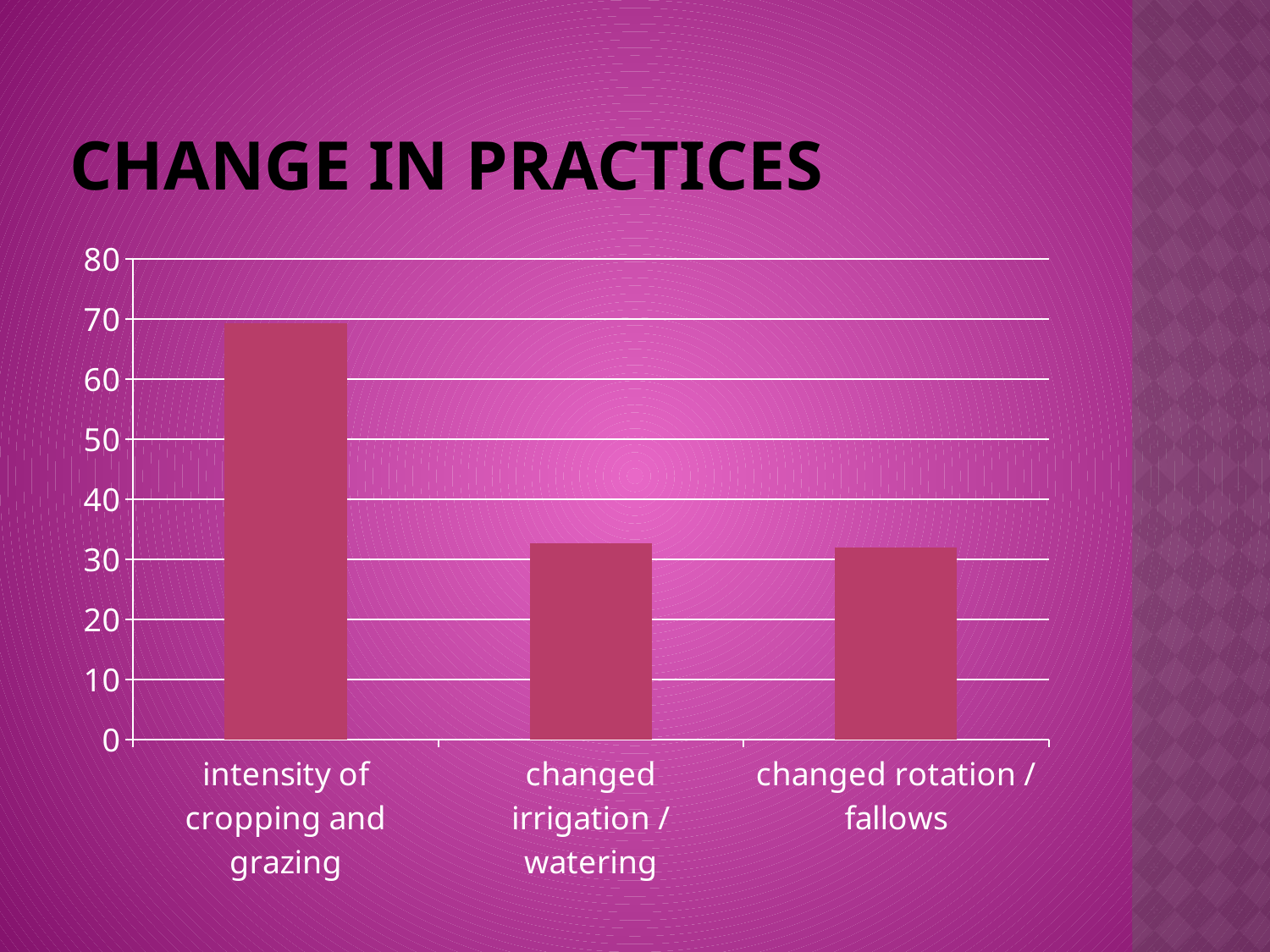
Which is larger, the value for intensity of cropping and grazing or the value for changed irrigation / watering? intensity of cropping and grazing Is the value for changed irrigation / watering greater or less than 40? less Is the value for changed rotation / fallows greater or less than 20? greater What kind of chart is shown on the slide? bar chart Is the value for changed rotation / fallows greater or less than 40? less Which category has the highest value? intensity of cropping and grazing What is the highest value shown on the vertical axis? 80 What is the title of the slide containing the chart? CHANGE IN PRACTICES How many categories are plotted on the chart? 3